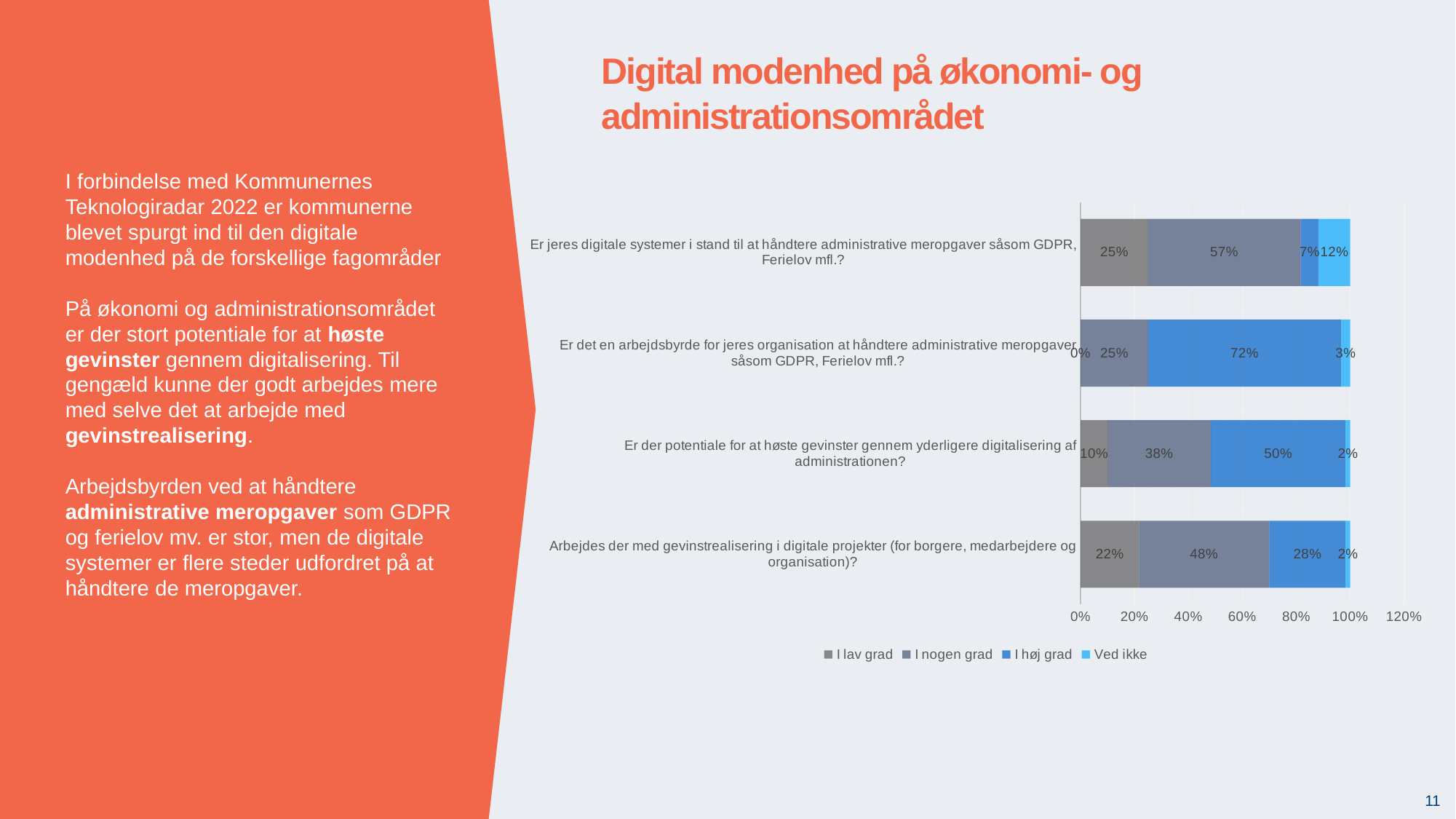
How many categories (questions) are plotted in the chart? 4 What is the title of the chart's slide? Digital modenhed på økonomi- og administrationsområdet What is the 'I høj grad' value for 'Er det en arbejdsbyrde for jeres organisation at håndtere administrative meropgaver såsom GDPR, Ferielov mfl.?' 72% What is the 'Ved ikke' value for 'Er jeres digitale systemer i stand til at håndtere administrative meropgaver såsom GDPR, Ferielov mfl.?' 12% What is the difference between the 'I høj grad' values for 'Er der potentiale for at høste gevinster gennem yderligere digitalisering af administrationen?' and 'Arbejdes der med gevinstrealisering i digitale projekter (for borgere, medarbejdere og organisation)?' 22% What is the 'I nogen grad' value for 'Arbejdes der med gevinstrealisering i digitale projekter (for borgere, medarbejdere og organisation)?' 48% Which is larger: the 'I nogen grad' value for 'Er jeres digitale systemer i stand til at håndtere administrative meropgaver såsom GDPR, Ferielov mfl.?' or for 'Er der potentiale for at høste gevinster gennem yderligere digitalisering af administrationen?' Er jeres digitale systemer i stand til at håndtere administrative meropgaver såsom GDPR, Ferielov mfl.? Which category has the lowest 'I lav grad' value? Er det en arbejdsbyrde for jeres organisation at håndtere administrative meropgaver såsom GDPR, Ferielov mfl.? What kind of chart is shown on the slide? Stacked bar chart Which category has the highest 'I høj grad' value? Er det en arbejdsbyrde for jeres organisation at håndtere administrative meropgaver såsom GDPR, Ferielov mfl.? How many series does the legend list? 4 What is the 'I lav grad' value for 'Er der potentiale for at høste gevinster gennem yderligere digitalisering af administrationen?' 10%